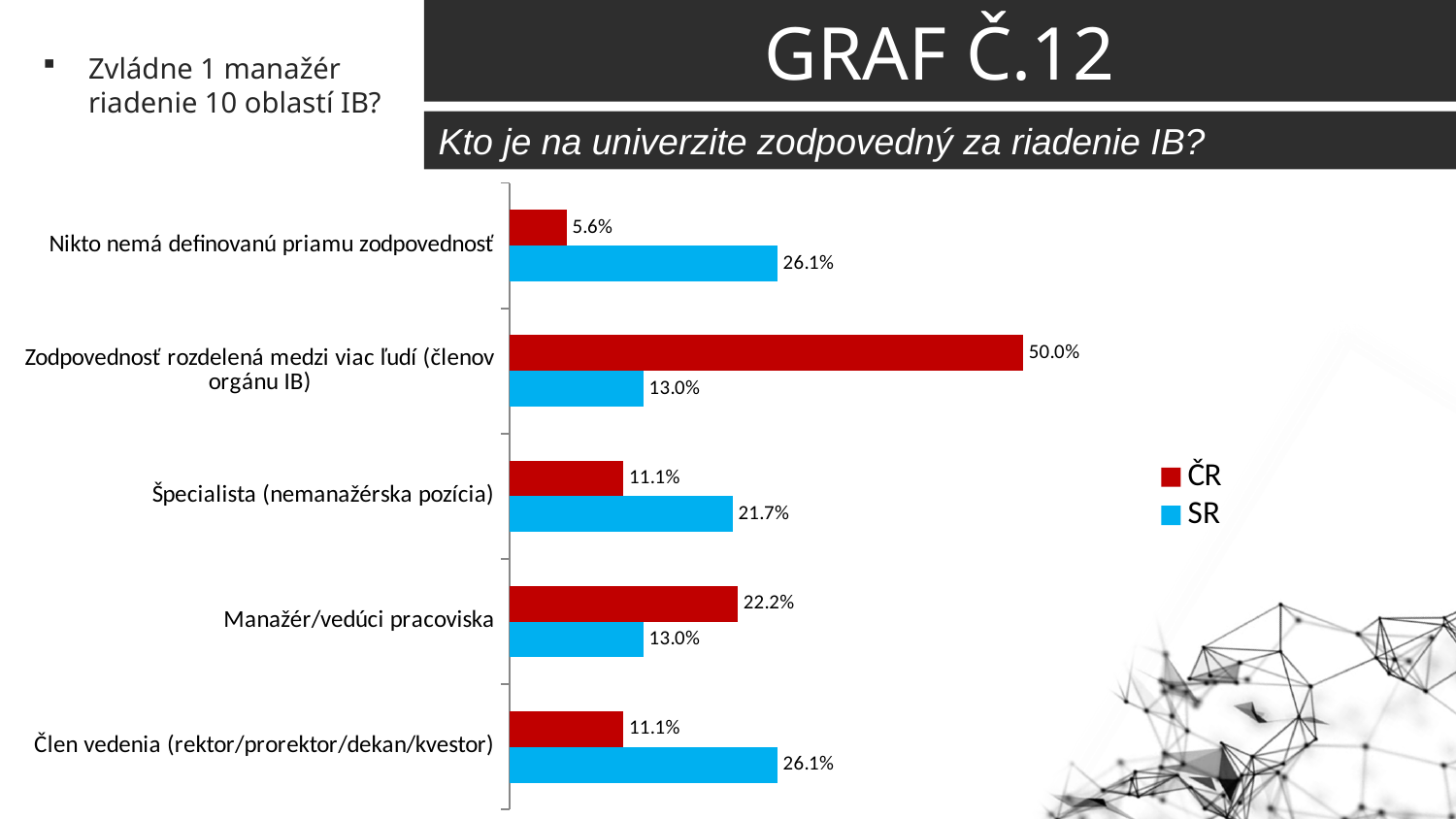
Which colour represents the SR series in the chart? Blue Which category has the lowest ČR value? Nikto nemá definovanú priamu zodpovednosť What is the SR value for "Špecialista (nemanažérska pozícia)"? 21.7% What kind of chart is shown on the slide? Bar chart What is the difference between the ČR and SR values for "Zodpovednosť rozdelená medzi viac ľudí (členov orgánu IB)"? 37.0% How many categories are shown on the chart? 5 Which category has the highest ČR value? Zodpovednosť rozdelená medzi viac ľudí (členov orgánu IB) What is the ČR value for "Manažér/vedúci pracoviska"? 22.2% What is the SR value for "Nikto nemá definovanú priamu zodpovednosť"? 26.1% How many series does the legend list? 2 For "Člen vedenia (rektor/prorektor/dekan/kvestor)", which is larger, the ČR value or the SR value? SR What is the ČR value for "Zodpovednosť rozdelená medzi viac ľudí (členov orgánu IB)"? 50.0%